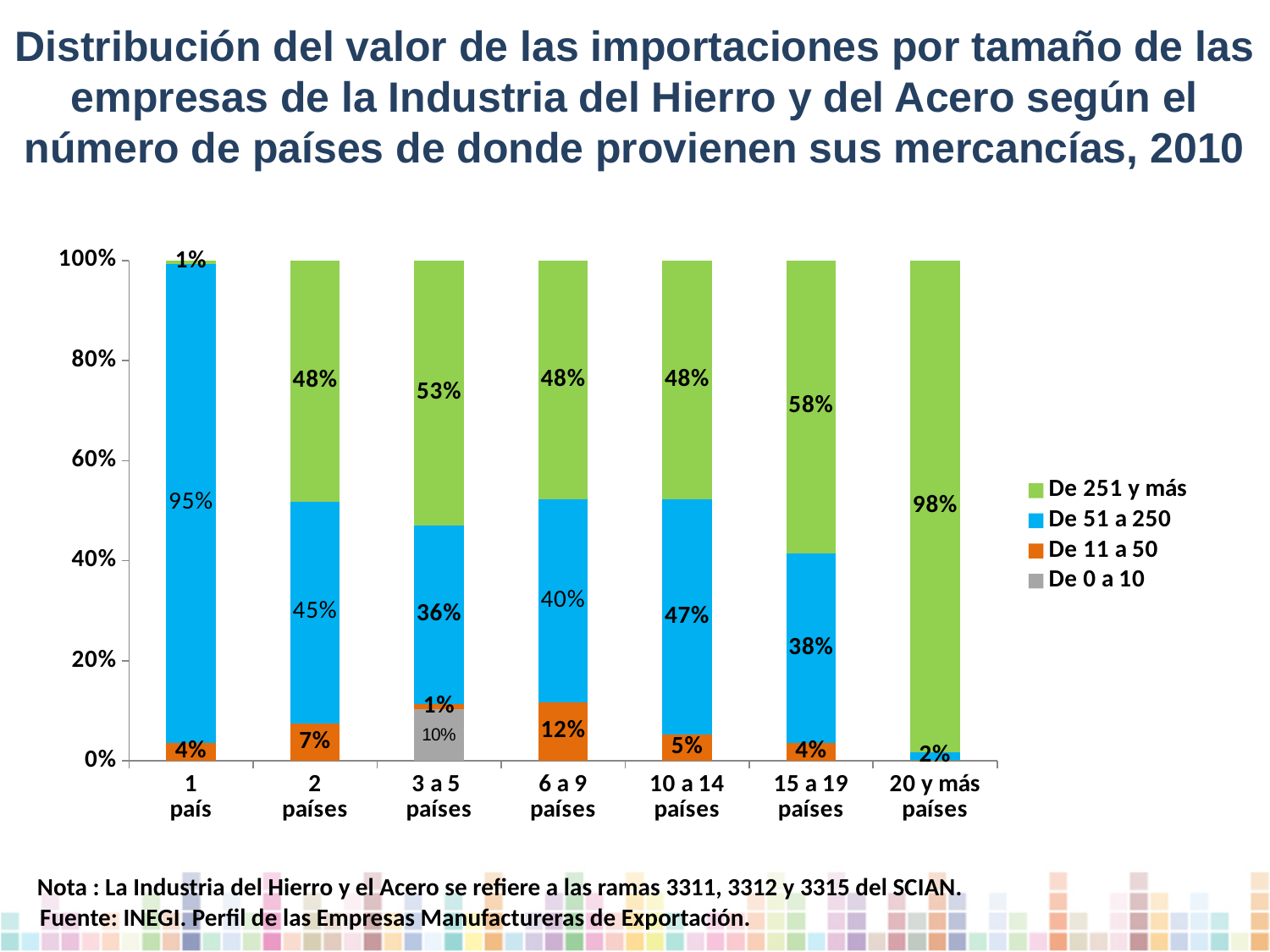
What share of import value for companies importing from 1 país corresponds to the 'De 51 a 250' size group? 95% Which is larger: the 'De 51 a 250' share for 2 países or for 3 a 5 países? 2 países What is the 'De 0 a 10' share for companies importing from 3 a 5 países? 10% What is the difference between the 'De 251 y más' share for 15 a 19 países and for 2 países? 10 percentage points What is the 'De 11 a 50' share for companies importing from 6 a 9 países? 12% How many country-count categories are shown on the x axis? 7 Which country-count category has the highest 'De 251 y más' share? 20 y más países How many company size groups does the legend list? 4 Which colour represents the 'De 11 a 50' size group in the chart? Orange What share of import value for companies importing from 20 y más países corresponds to the 'De 251 y más' size group? 98% What type of chart is shown on the slide? Stacked bar chart Which country-count category has the lowest 'De 51 a 250' share? 20 y más países